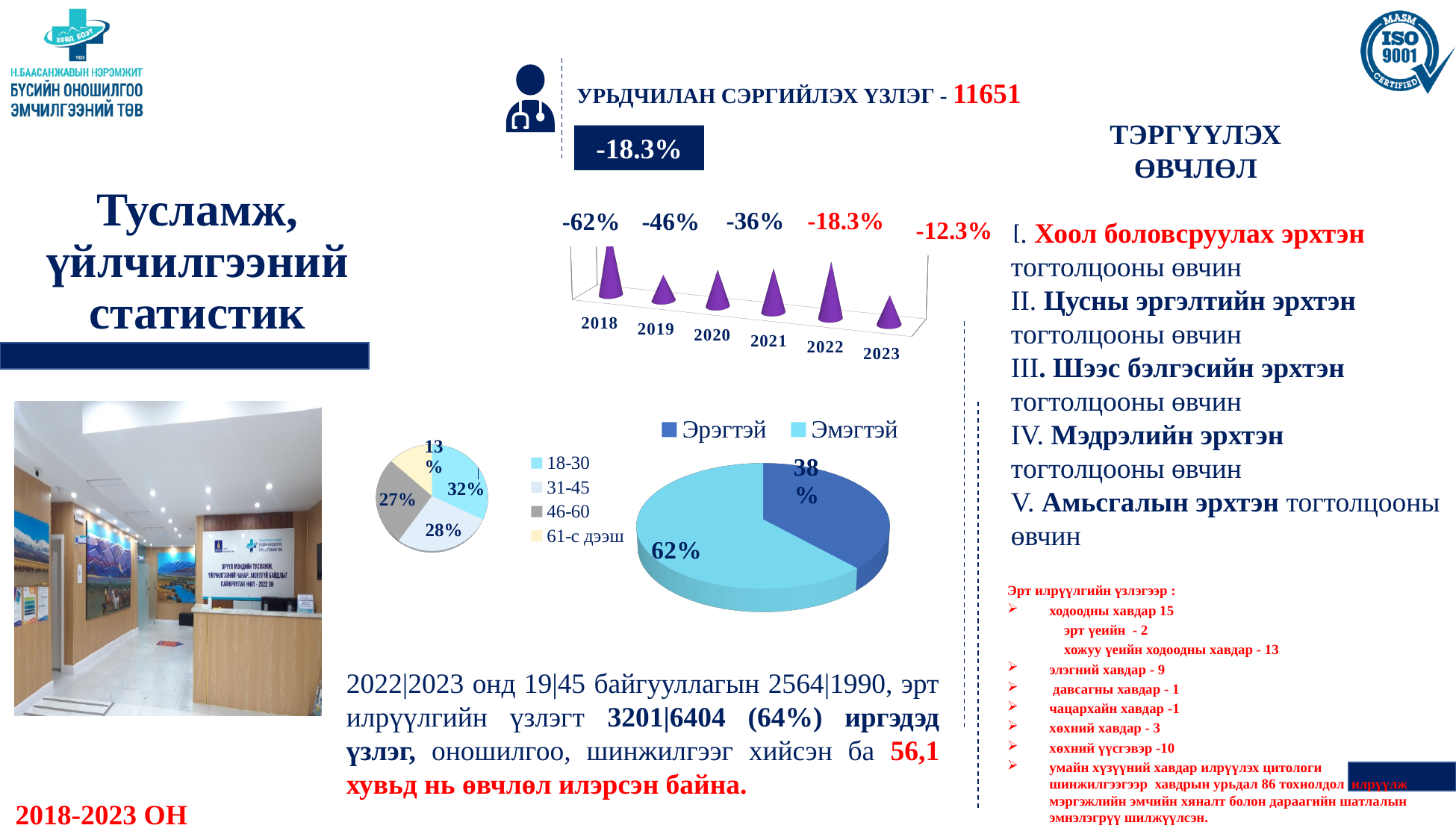
In the age-group pie chart, which age group has the smallest share? 61-с дээш In the age-group pie chart, what share is shown for the 46-60 group? 27% In the age-group pie chart, which age group has the largest share? 18-30 In the age-group pie chart, what share is shown for the 61-с дээш group? 13% In the cone chart of years 2018-2023 at the top of the slide, which year has the tallest cone? 2018 In the age-group pie chart, what share is shown for the 18-30 group? 32% In the age-group pie chart, what is the difference between the 18-30 share and the 31-45 share? 4% In the gender pie chart, which is larger, the Эрэгтэй share or the Эмэгтэй share? Эмэгтэй In the age-group pie chart, how many age groups does the legend list? 4 In the gender pie chart, how many series does the legend list? 2 In the gender pie chart (Эрэгтэй / Эмэгтэй), what share is shown for Эрэгтэй? 38% In the gender pie chart (Эрэгтэй / Эмэгтэй), what share is shown for Эмэгтэй? 62%